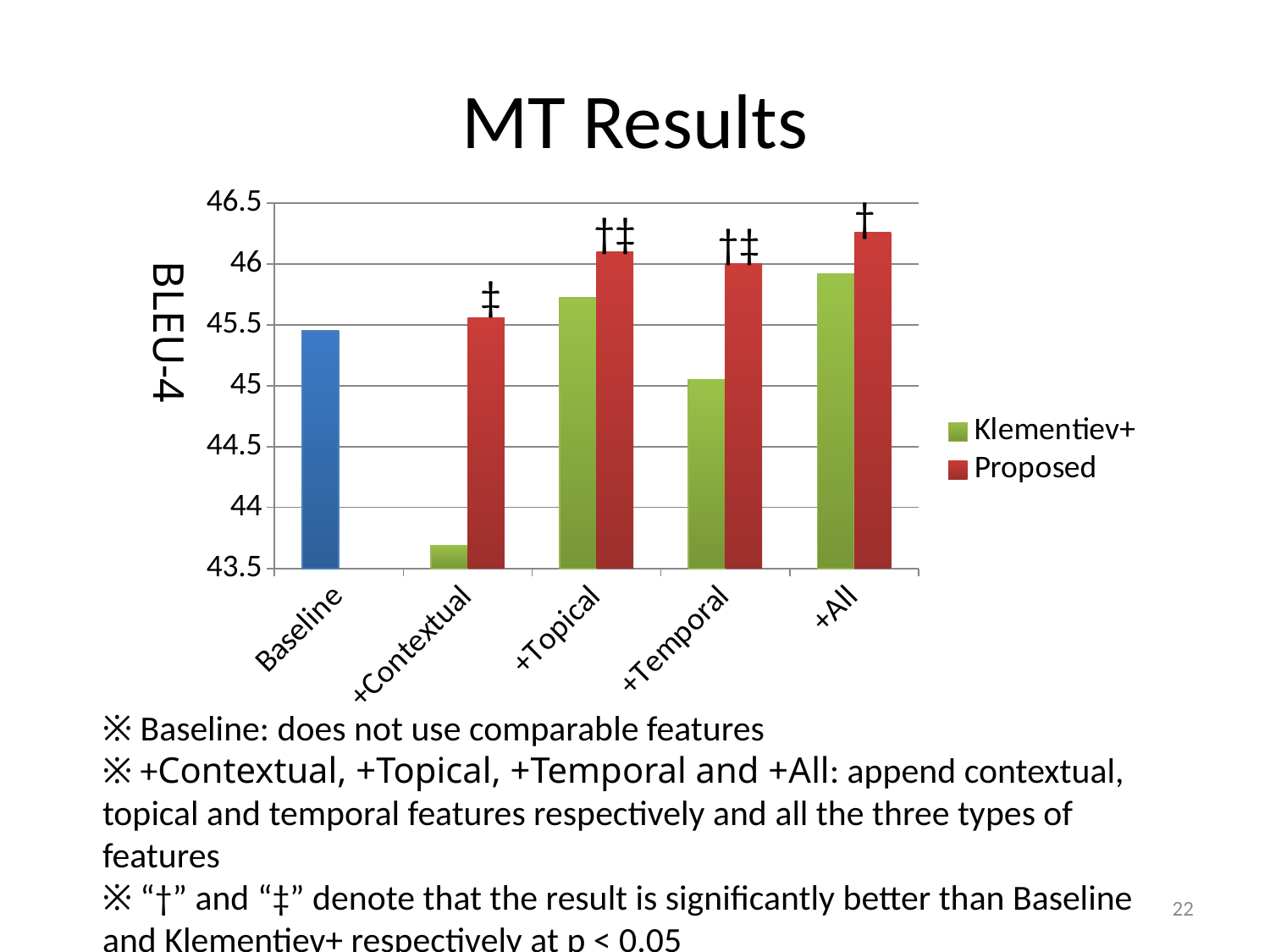
For which category is the Proposed value highest? +All Is the Klementiev+ value for +Temporal greater or less than 45.5? less What is the title of the chart? MT Results For +Topical, which is larger: the Klementiev+ value or the Proposed value? Proposed How many series does the chart's legend list? 2 What kind of chart is shown on the slide? bar chart For which category is the Klementiev+ value lowest? +Contextual What is the label of the y axis? BLEU-4 Is the Proposed value for +Contextual greater or less than 45? greater Is the Proposed value for +Topical greater or less than 46? greater How many categories are shown on the x axis of the chart? 5